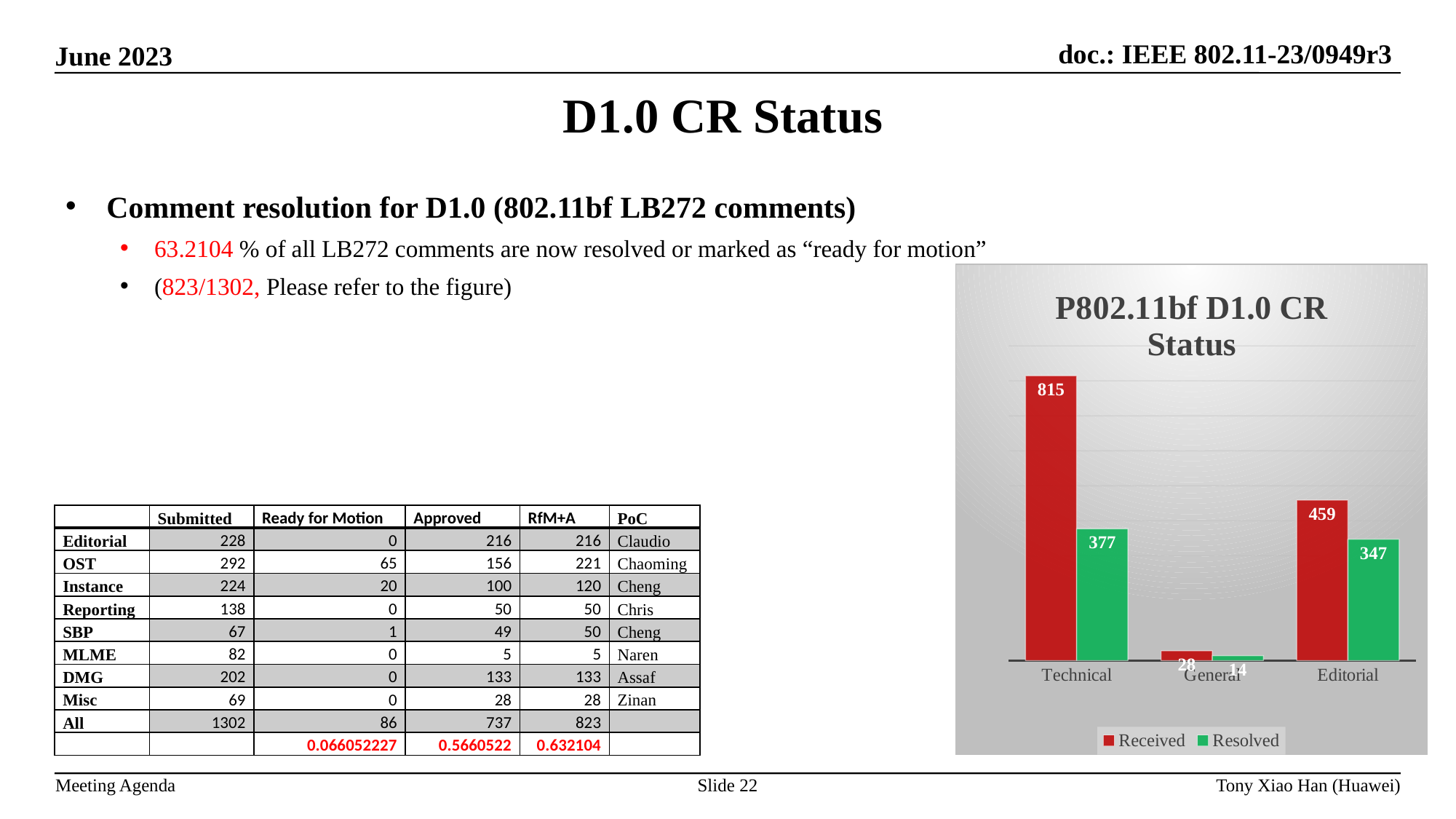
How many series does the chart legend list? 2 Which category has the lowest Resolved value in the chart? General What is the Resolved value for Technical in the chart? 377 Which category has the highest Received value in the chart? Technical What is the title of the chart? P802.11bf D1.0 CR Status What is the Received value for General in the chart? 28 How many categories are shown on the x axis of the chart? 3 What is the difference between Received and Resolved for Technical in the chart? 438 Which is larger in the chart: the Received value for Editorial or the Resolved value for Technical? Received value for Editorial What is the Resolved value for Editorial in the chart? 347 What is the Received value for Technical in the chart? 815 What is the difference between Received and Resolved for Editorial in the chart? 112